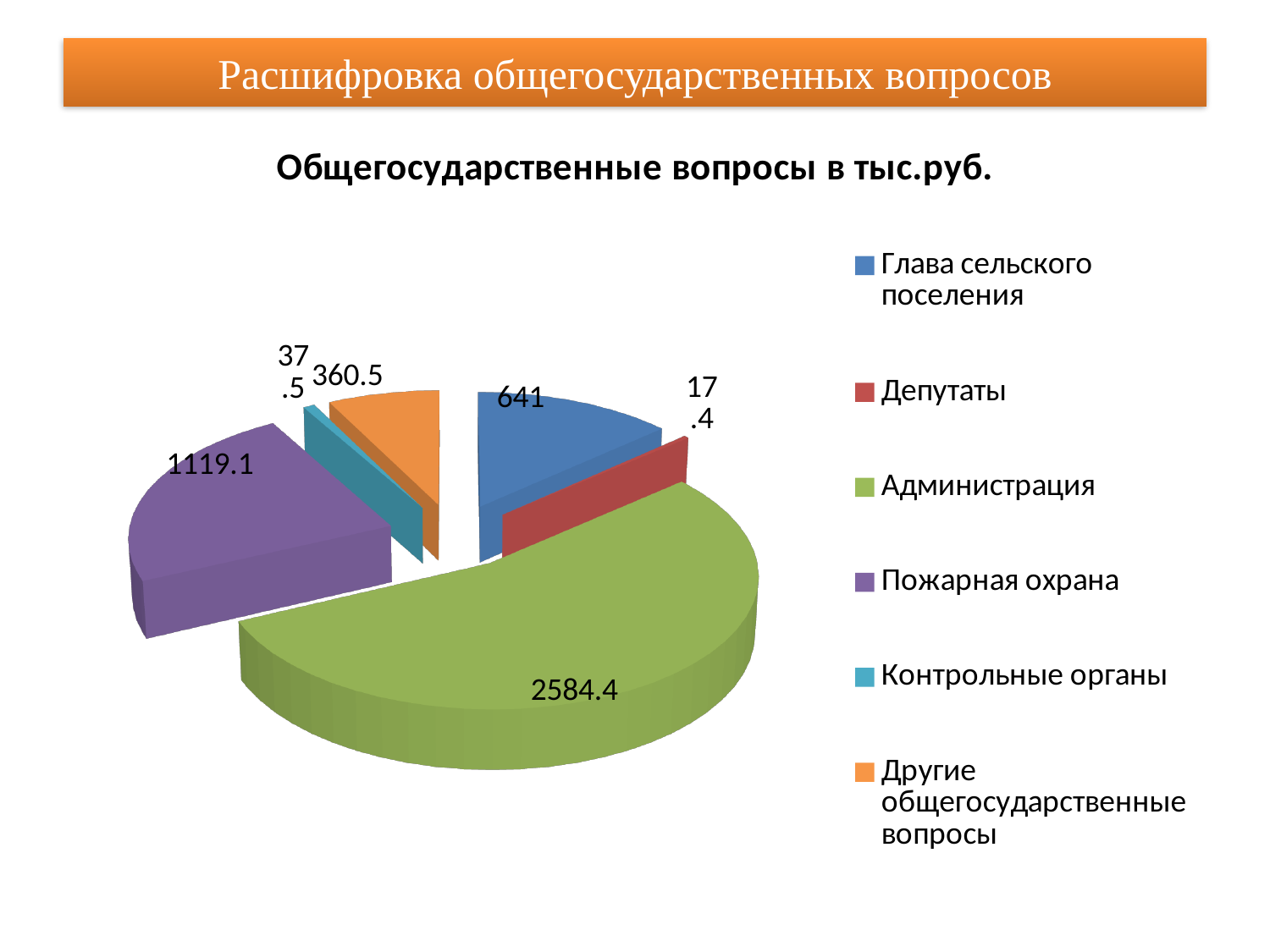
Which is larger, the value for Глава сельского поселения or the value for Другие общегосударственные вопросы? Глава сельского поселения What is the difference between the values for Администрация and Пожарная охрана? 1465.3 What is the value for Депутаты in the pie chart? 17.4 How many categories does the pie chart show? 6 Which category has the largest slice in the pie chart? Администрация What is the value for Администрация in the pie chart? 2584.4 What is the value for Пожарная охрана in the pie chart? 1119.1 What is the value for Другие общегосударственные вопросы in the pie chart? 360.5 What is the value for Глава сельского поселения in the pie chart? 641 What is the title of the chart? Общегосударственные вопросы в тыс.руб. What kind of chart is shown on the slide? Pie chart Which category has the smallest slice in the pie chart? Депутаты